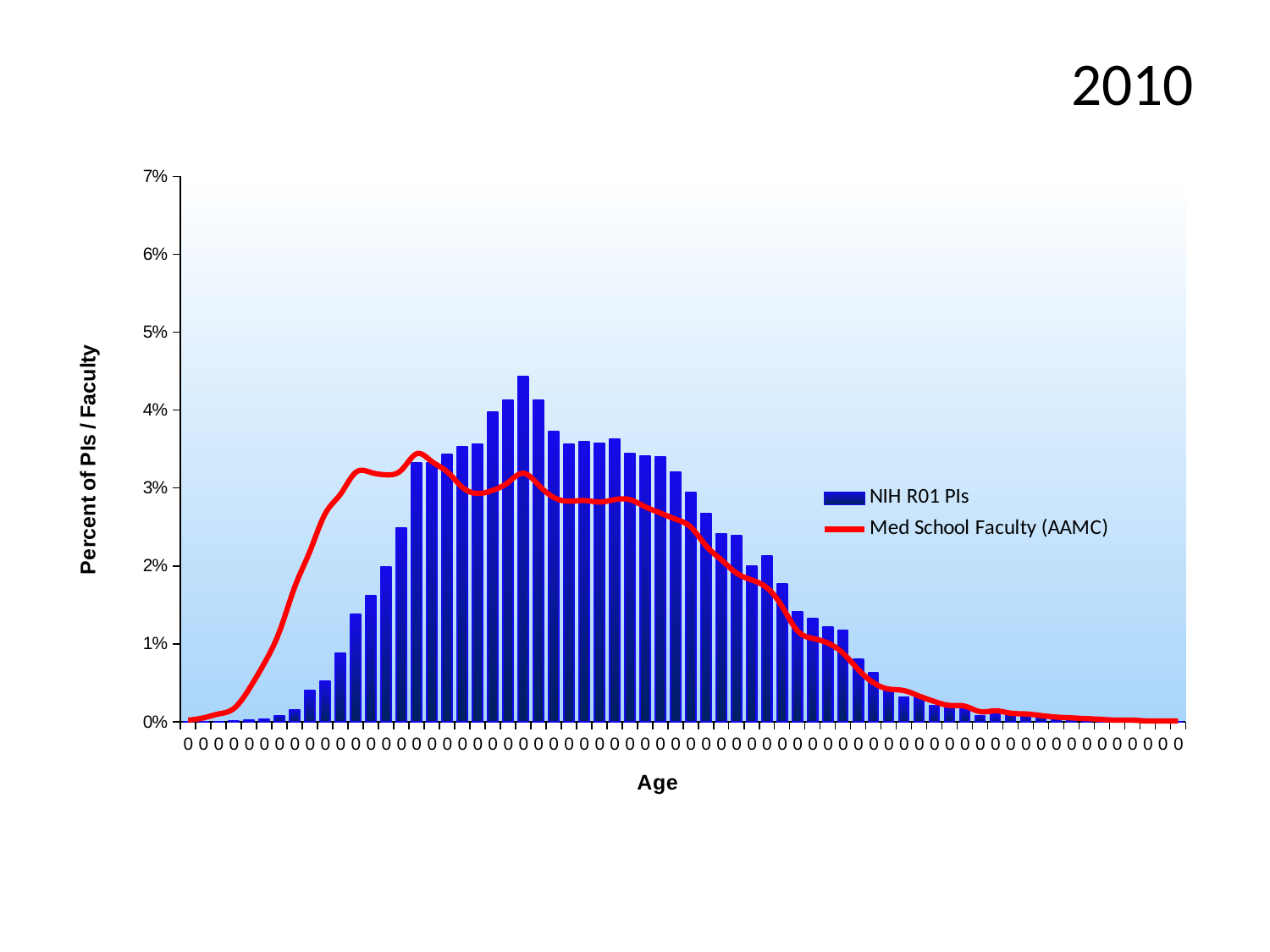
What kind of chart is shown on the slide? A bar chart with a line overlay Which reaches a higher peak value, the NIH R01 PIs bars or the Med School Faculty (AAMC) line? NIH R01 PIs Is the tallest NIH R01 PIs bar greater or less than 4%? greater Toward the right end of the x axis, do the NIH R01 PIs bars rise or fall? fall What is the label of the y axis? Percent of PIs / Faculty Is the tallest NIH R01 PIs bar greater or less than 5%? less How many series does the legend list? 2 Is the peak of the Med School Faculty (AAMC) line greater or less than 4%? less Which series is drawn as a red line? Med School Faculty (AAMC) What is the label of the x axis? Age Which series is drawn as blue bars? NIH R01 PIs What year is shown as the title of the slide? 2010